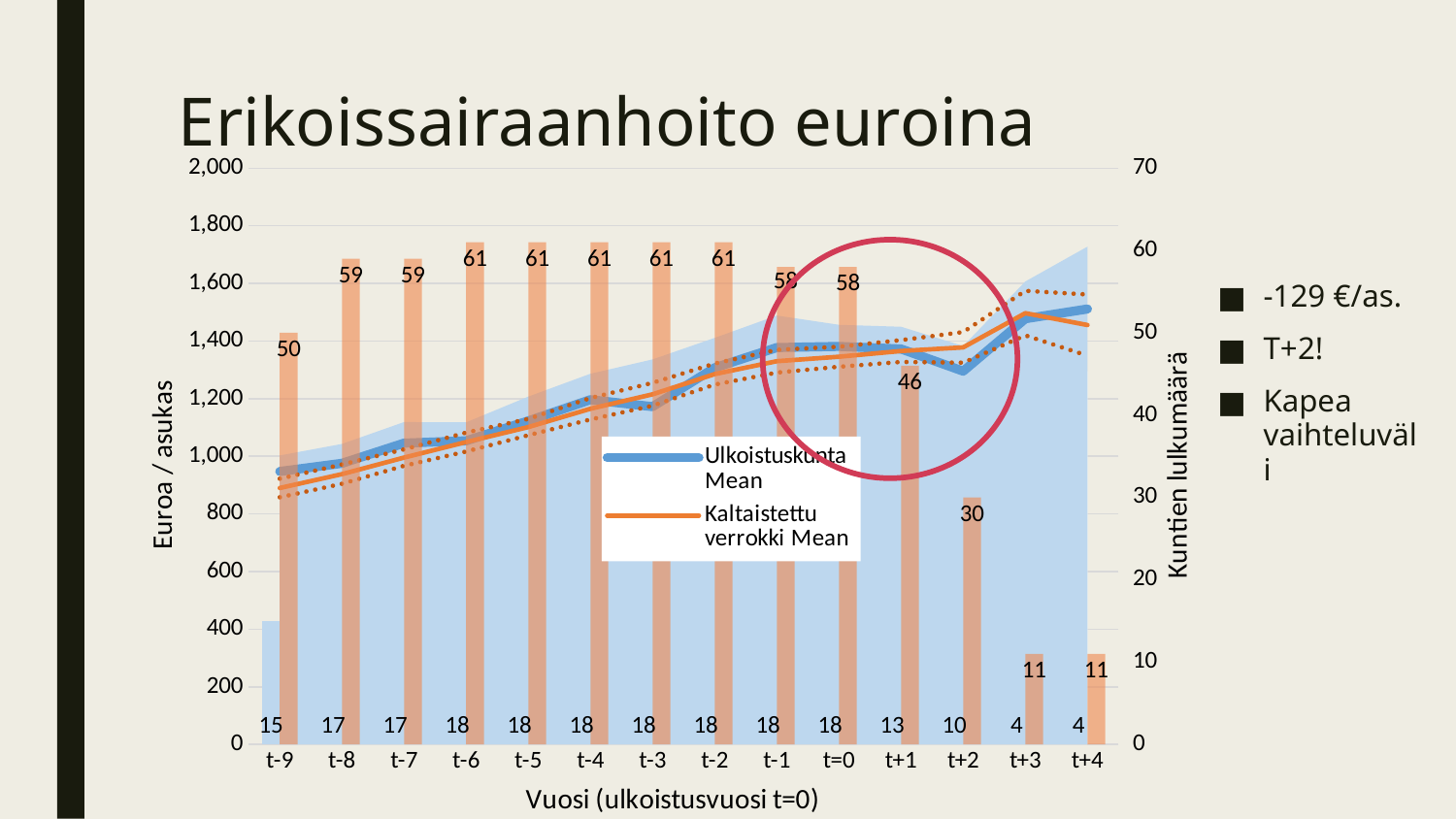
How many categories are shown on the x axis? 14 What is the label of the right-hand vertical axis? Kuntien lukumäärä How many series does the legend list? 2 What is the value of the orange bar at t+1? 46 What is the value of the orange bar at t-9? 50 Which orange bar is taller, t-8 or t+1? t-8 What is the title of the chart? Erikoissairaanhoito euroina What is the difference between the orange bar values at t=0 and t+2? 28 What is the value of the orange bar at t+2? 30 Is the Ulkoistuskunta Mean value at t-9 greater or less than 1,000? less Does the Ulkoistuskunta Mean line generally rise or fall from t-9 to t+4? rise What kind of chart is this? Combined area, bar and line chart